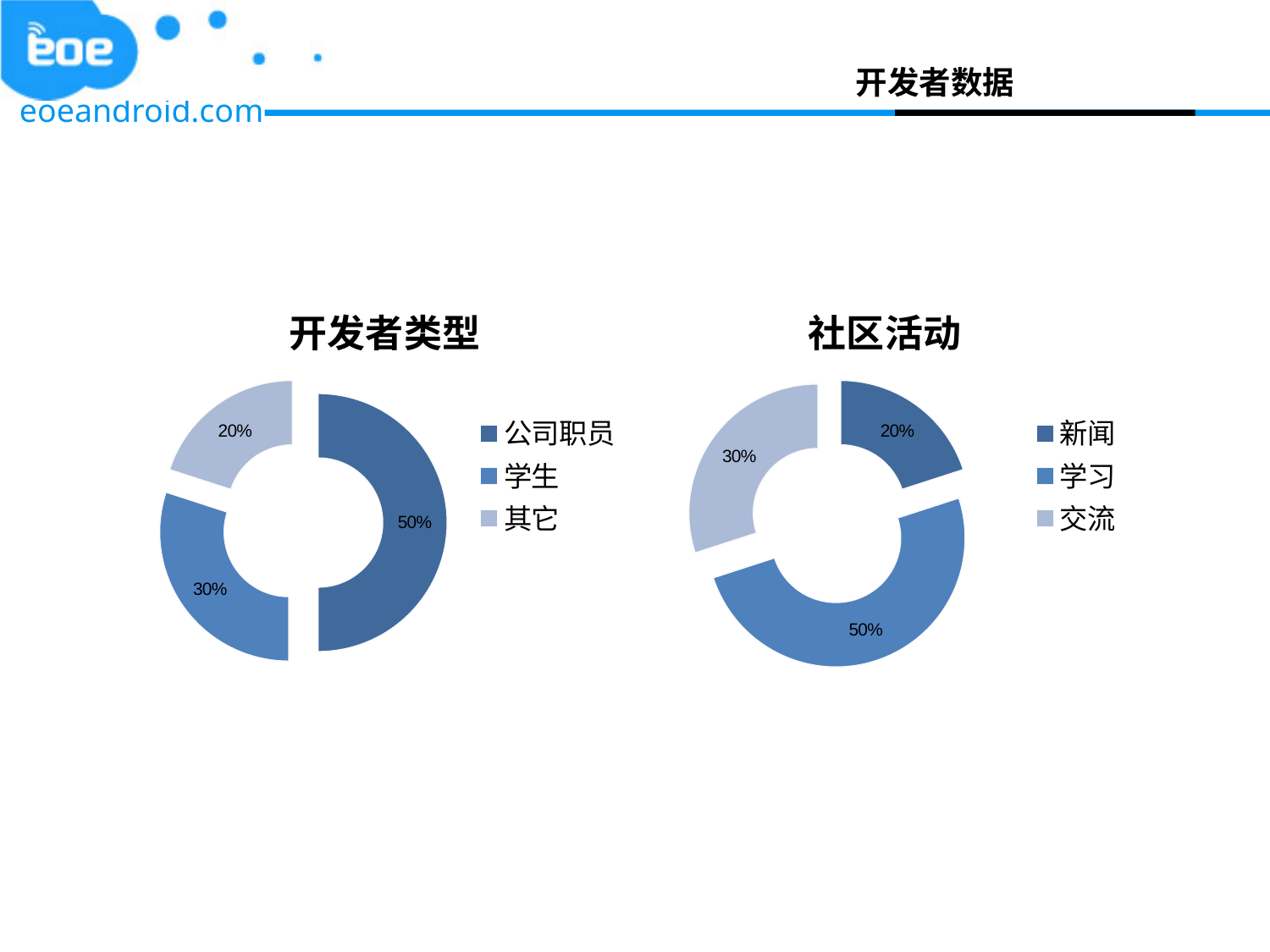
What kind of chart is the 社区活动 chart? Doughnut (pie) chart In the 开发者类型 chart, what share is labelled for 公司职员? 50% In the 开发者类型 chart, which category has the smallest share? 其它 In the 社区活动 chart, which is larger, the share for 交流 or the share for 新闻? 交流 In the 社区活动 chart, what share is labelled for 交流? 30% In the 开发者类型 chart, which category has the largest share? 公司职员 In the 开发者类型 chart, what is the difference between the shares of 公司职员 and 学生? 20% In the 社区活动 chart, which category has the largest share? 学习 In the 社区活动 chart, what share is labelled for 学习? 50% In the 社区活动 chart, what share is labelled for 新闻? 20% In the 开发者类型 chart, what share is labelled for 学生? 30% In the 开发者类型 chart, what share is labelled for 其它? 20%